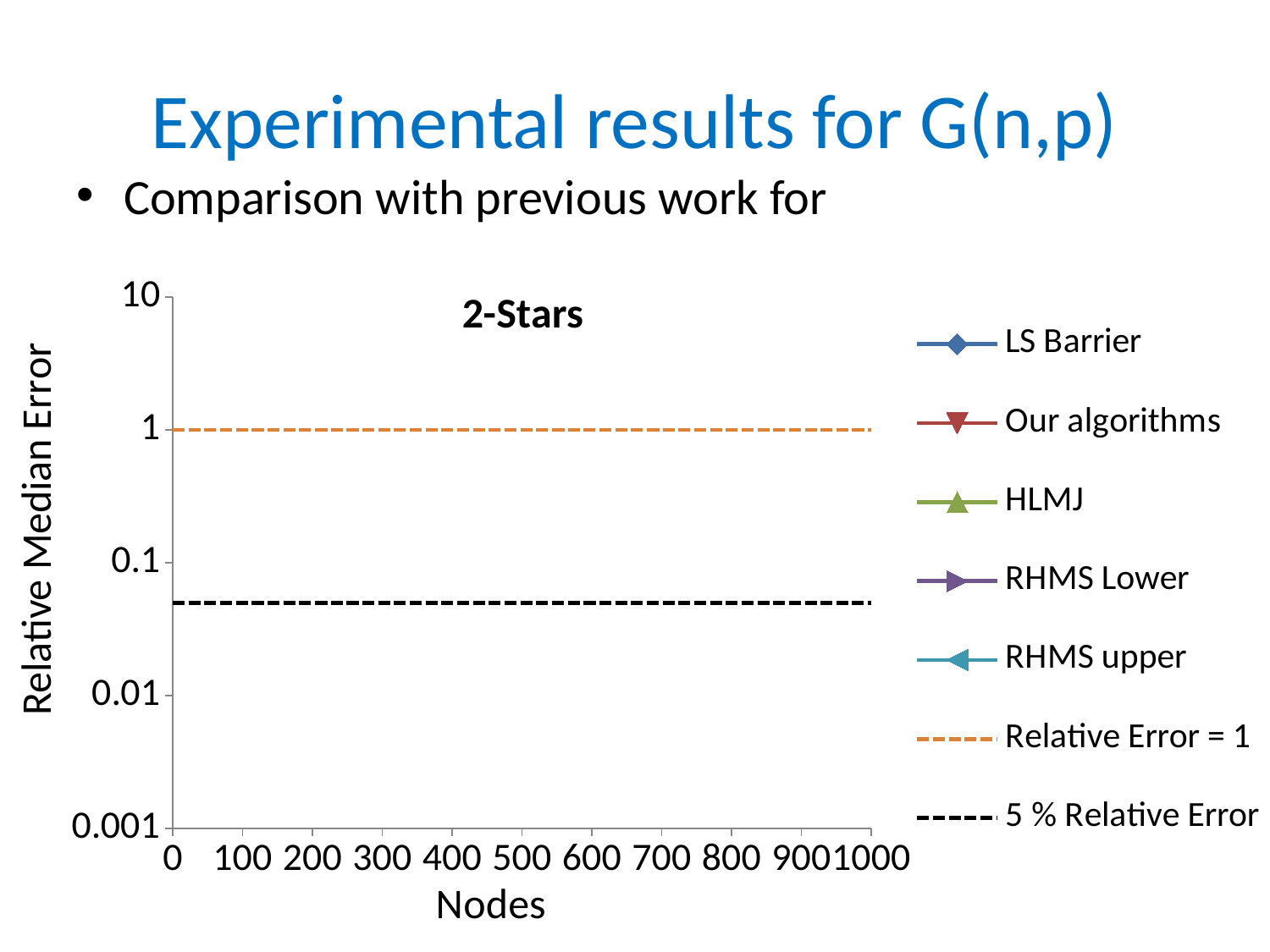
In the 2-Stars chart, which line is higher: 'Relative Error = 1' or '5 % Relative Error'? Relative Error = 1 In the 2-Stars chart, is the '5 % Relative Error' dashed line greater or less than 0.1? less How many series does the legend of the 2-Stars chart list? 7 In the 2-Stars chart, does the 'Relative Error = 1' line rise, fall, or stay constant as Nodes increases? stays constant In the 2-Stars chart, is the '5 % Relative Error' dashed line greater or less than 0.01? greater What is the lowest tick value shown on the y axis of the 2-Stars chart? 0.001 At what value on the y axis does the 'Relative Error = 1' dashed line sit in the 2-Stars chart? 1 In the 2-Stars chart, does the '5 % Relative Error' line rise, fall, or stay constant along the x axis? stays constant What is the title of the chart on the slide? 2-Stars What is the label of the y axis of the 2-Stars chart? Relative Median Error What kind of chart is shown on the slide? line chart What is the highest value shown on the x axis (Nodes) of the 2-Stars chart? 1000